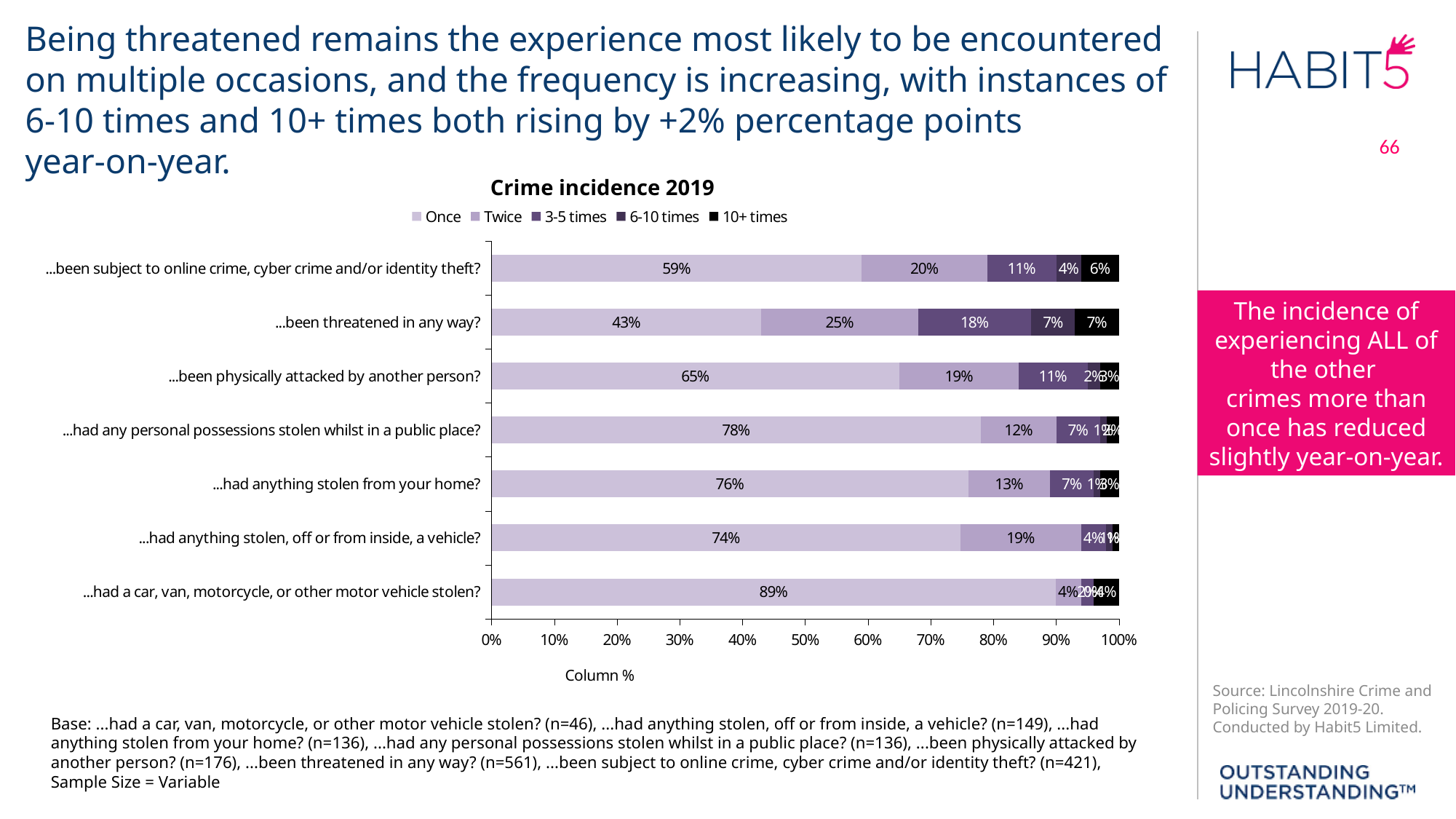
Which category has the lowest 'Once' value? ...been threatened in any way? Which category has the highest 'Once' value? ...had a car, van, motorcycle, or other motor vehicle stolen? What type of chart is shown on the slide? Stacked bar chart What is the 'Once' value for '...been threatened in any way?' 43% What is the '3-5 times' value for '...been threatened in any way?' 18% How many crime categories are plotted in the chart? 7 What is the difference between the 'Once' values for '...been subject to online crime, cyber crime and/or identity theft?' and '...been threatened in any way?' 16 percentage points How many series does the chart legend list? 5 What is the title of the chart? Crime incidence 2019 Is the 'Once' value for '...been threatened in any way?' greater or less than 50%? less Which is larger: the 'Twice' value for '...been threatened in any way?' or the 'Twice' value for '...been physically attacked by another person?' ...been threatened in any way? What is the 'Twice' value for '...been subject to online crime, cyber crime and/or identity theft?' 20%